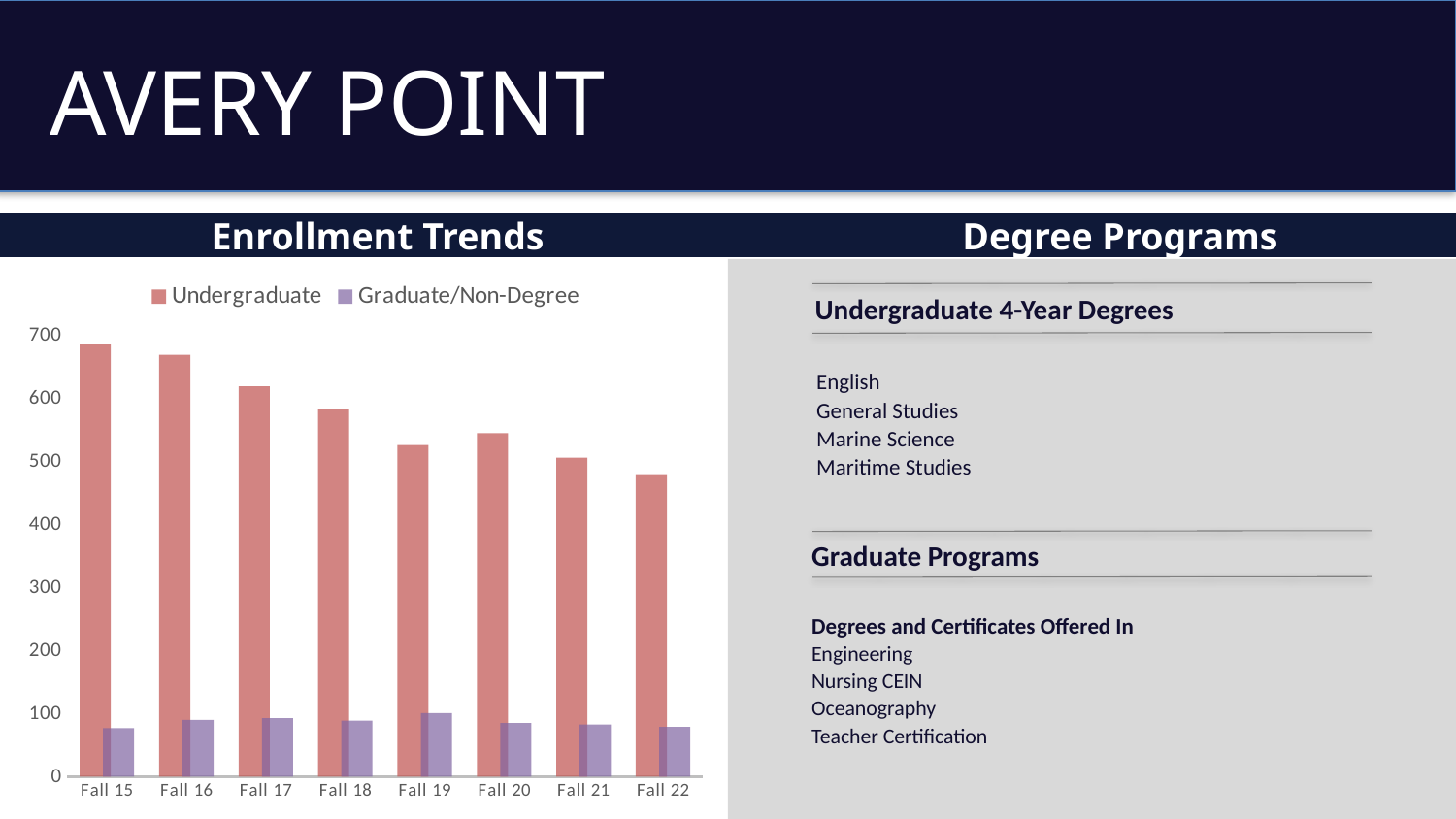
Which series in the Enrollment Trends chart is shown in purple? Graduate/Non-Degree Is the Graduate/Non-Degree value for Fall 15 greater or less than 100? less How many series does the legend of the Enrollment Trends chart list? 2 Which fall term has the highest Undergraduate enrollment in the Enrollment Trends chart? Fall 15 Is the Undergraduate value for Fall 15 greater or less than 600? greater Is the Undergraduate value for Fall 22 greater or less than 500? less Which fall term has the lowest Undergraduate enrollment in the Enrollment Trends chart? Fall 22 How many fall terms are shown on the x axis of the Enrollment Trends chart? 8 What kind of chart is shown under Enrollment Trends? bar chart Which fall term has the highest Graduate/Non-Degree enrollment in the Enrollment Trends chart? Fall 19 Which is larger, the Undergraduate value for Fall 19 or for Fall 20? Fall 20 Does Undergraduate enrollment generally rise or fall from Fall 15 to Fall 22? fall